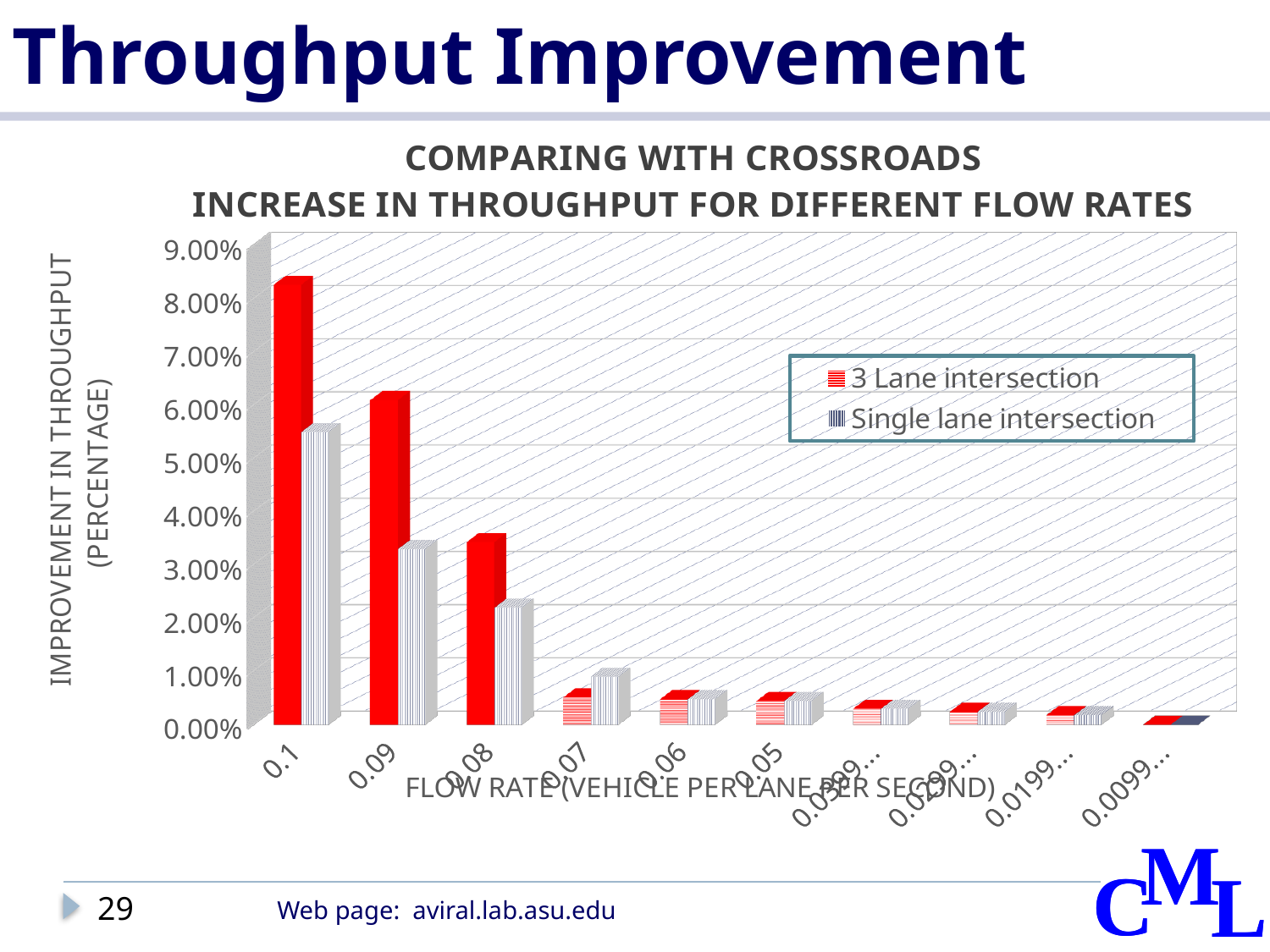
Is the value for the Single lane intersection at flow rate 0.08 greater or less than 2.00%? greater Is the value for the 3 Lane intersection at flow rate 0.07 greater or less than 1.00%? less Is the value for the 3 Lane intersection at flow rate 0.09 greater or less than 7.00%? less Which flow rate has the highest value for the 3 Lane intersection series? 0.1 How many flow rate categories are plotted on the x axis? 10 Do the values for the 3 Lane intersection series rise or fall moving from left to right along the x axis? Fall Which flow rate has the highest value for the Single lane intersection series? 0.1 How many series does the legend list? 2 What kind of chart is shown on the slide? Bar chart At flow rate 0.1, which series has the larger value, 3 Lane intersection or Single lane intersection? 3 Lane intersection